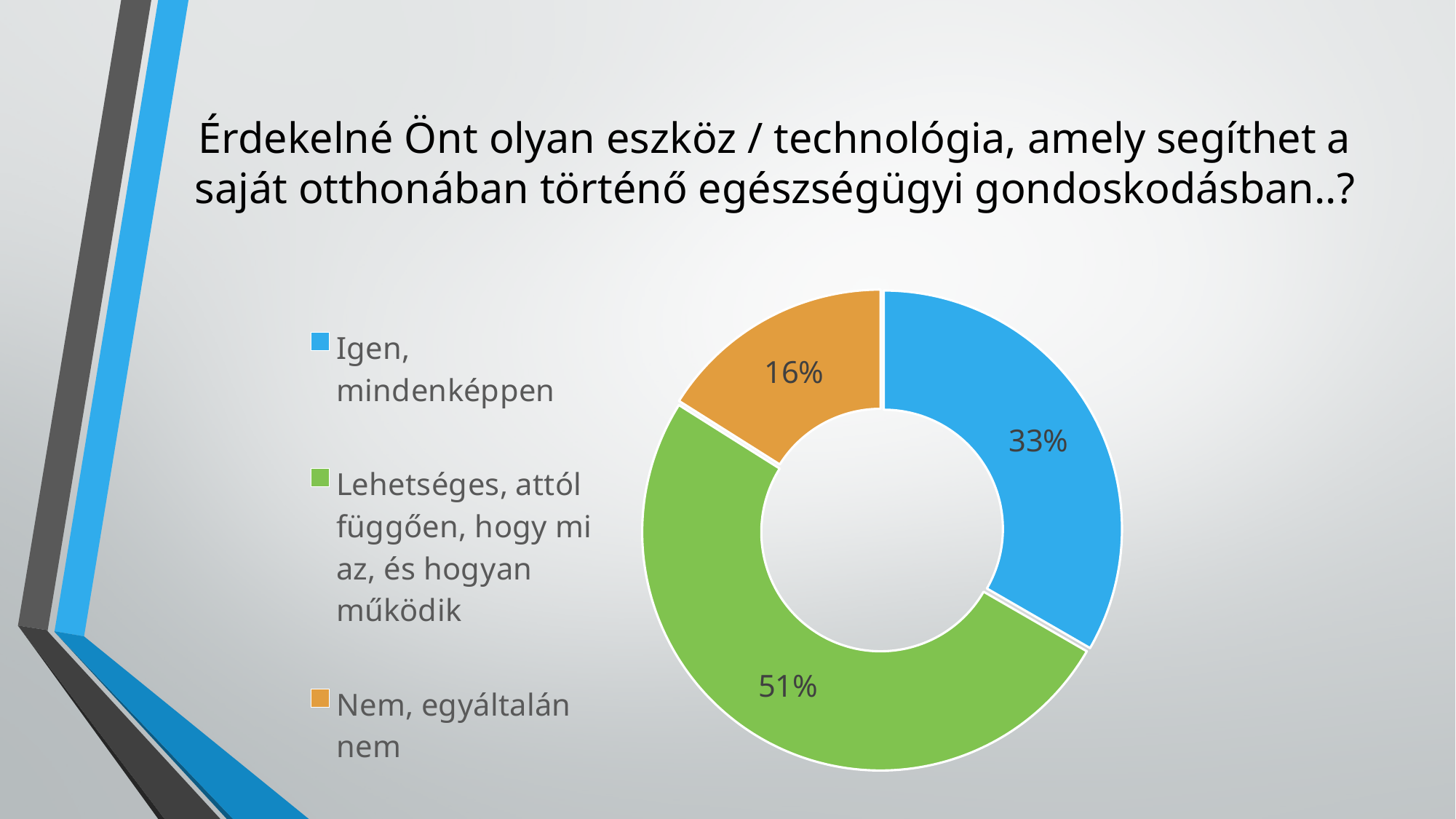
Which category has the smallest share of the chart? Nem, egyáltalán nem Which is larger: the share for "Igen, mindenképpen" or the share for "Nem, egyáltalán nem"? Igen, mindenképpen What kind of chart is shown on the slide? Doughnut (pie) chart What share of the chart does "Lehetséges, attól függően, hogy mi az, és hogyan működik" represent? 51% Which category has the largest share of the chart? Lehetséges, attól függően, hogy mi az, és hogyan működik What colour is the slice for "Igen, mindenképpen"? Blue What share of the chart does "Nem, egyáltalán nem" represent? 16% What is the difference in percentage points between "Igen, mindenképpen" and "Nem, egyáltalán nem"? 17 percentage points What colour is the slice for "Nem, egyáltalán nem"? Orange How many categories does the chart show? 3 What is the difference in percentage points between "Lehetséges, attól függően, hogy mi az, és hogyan működik" and "Igen, mindenképpen"? 18 percentage points What share of the chart does "Igen, mindenképpen" represent? 33%